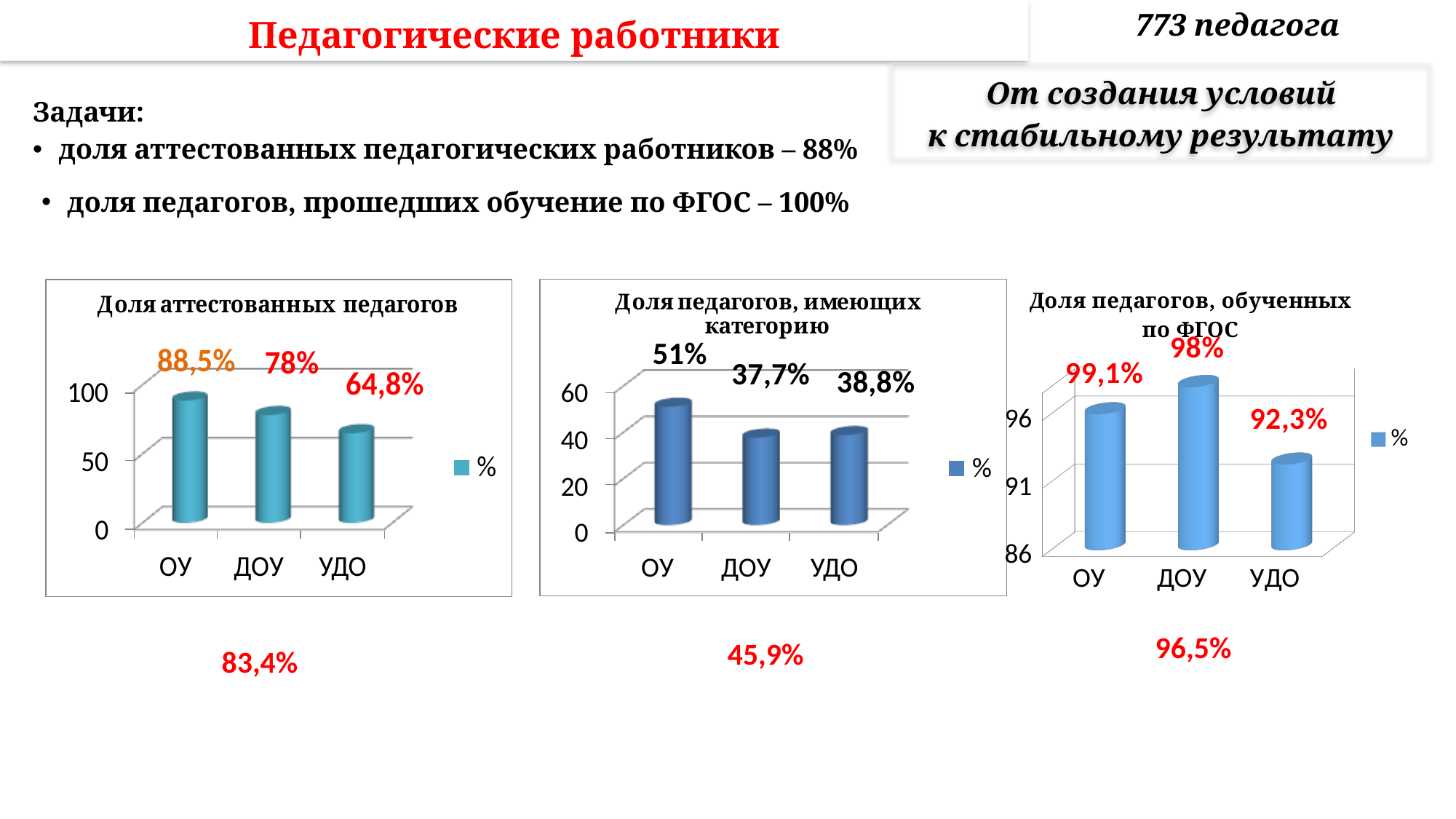
In the chart titled "Доля педагогов, имеющих категорию", which category has the highest value? ОУ In the chart titled "Доля аттестованных педагогов", which category has the lowest value? УДО In the chart titled "Доля педагогов, имеющих категорию", what is the value for ДОУ? 37,7% In the chart titled "Доля аттестованных педагогов", what is the value for ОУ? 88,5% In the chart titled "Доля педагогов, имеющих категорию", which is larger, the value for ДОУ or the value for УДО? УДО In the chart titled "Доля педагогов, обученных по ФГОС", what is the difference between the values for ОУ and УДО? 6,8 percentage points In the chart titled "Доля педагогов, имеющих категорию", what is the difference between the values for ОУ and ДОУ? 13,3 percentage points In the chart titled "Доля педагогов, обученных по ФГОС", what is the value for УДО? 92,3% What kind of chart is the chart titled "Доля педагогов, обученных по ФГОС"? Bar chart How many categories are shown on the x axis of the chart titled "Доля аттестованных педагогов"? 3 In the chart titled "Доля аттестованных педагогов", what is the difference between the values for ОУ and УДО? 23,7 percentage points